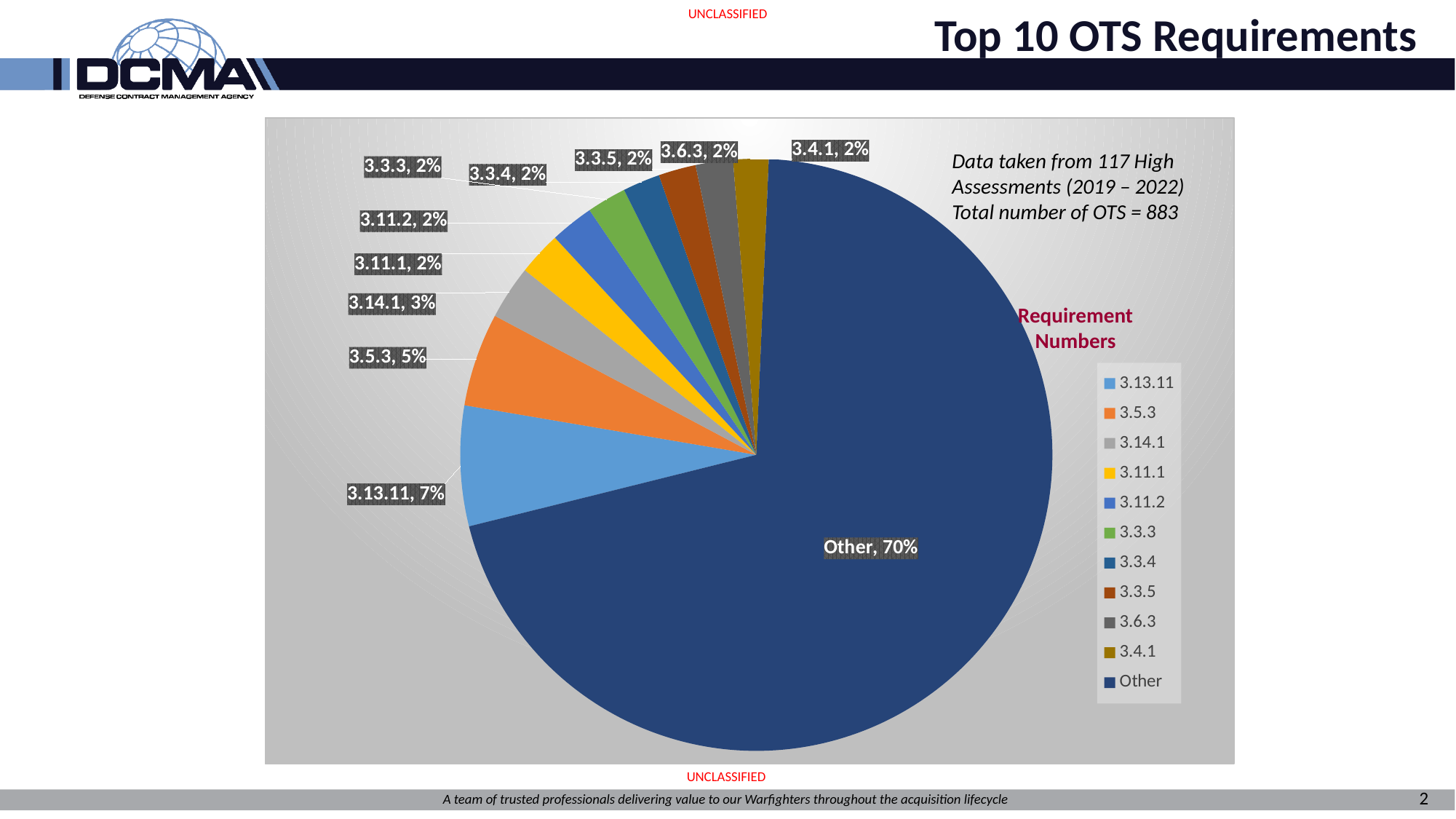
What is the value shown for requirement 3.14.1? 3% What kind of chart is shown on the slide? pie chart What is the value shown for requirement 3.13.11? 7% What is the value shown for requirement 3.3.3? 2% Which has a larger share, 3.5.3 or 3.14.1? 3.5.3 Which slice of the pie is the largest? Other What share of the pie does the Other slice represent? 70% How many entries does the legend list? 11 What is the value shown for requirement 3.5.3? 5% Which of the named requirements (excluding Other) has the largest share? 3.13.11 What is the difference between the shares for 3.13.11 and 3.5.3? 2% What is the legend title shown on the chart? Requirement Numbers